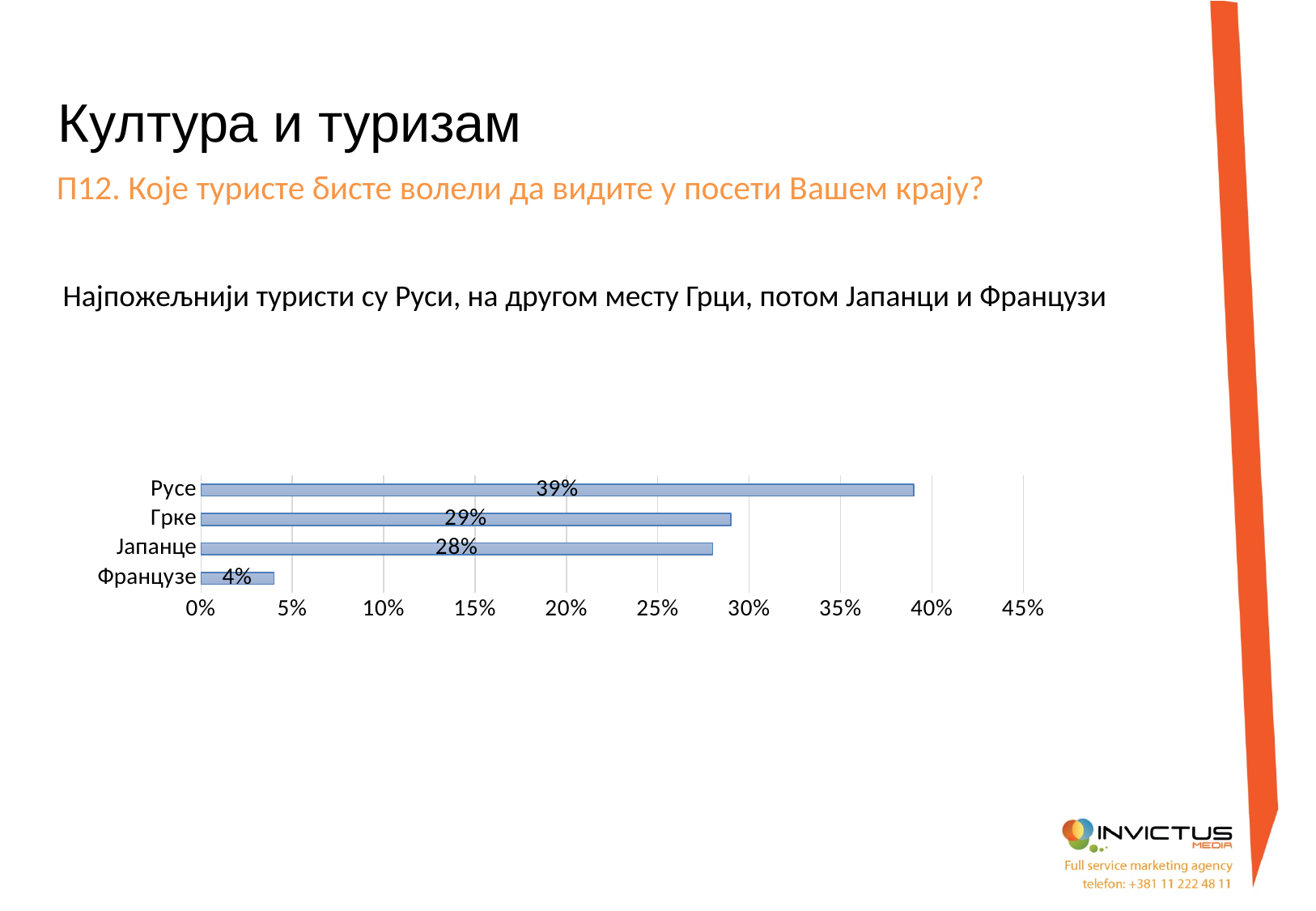
What is the difference between the values for Јапанце and Французе? 24% How many categories are shown in the chart? 4 Which category has the highest value? Русе What is the difference between the values for Русе and Грке? 10% Which is larger, the value for Русе or the value for Французе? Русе What is the value for Русе? 39% What is the value for Французе? 4% Is the value for Грке greater or less than 25%? greater What is the value for Грке? 29% Which category has the lowest value? Французе What is the value for Јапанце? 28% What kind of chart is shown on the slide? bar chart